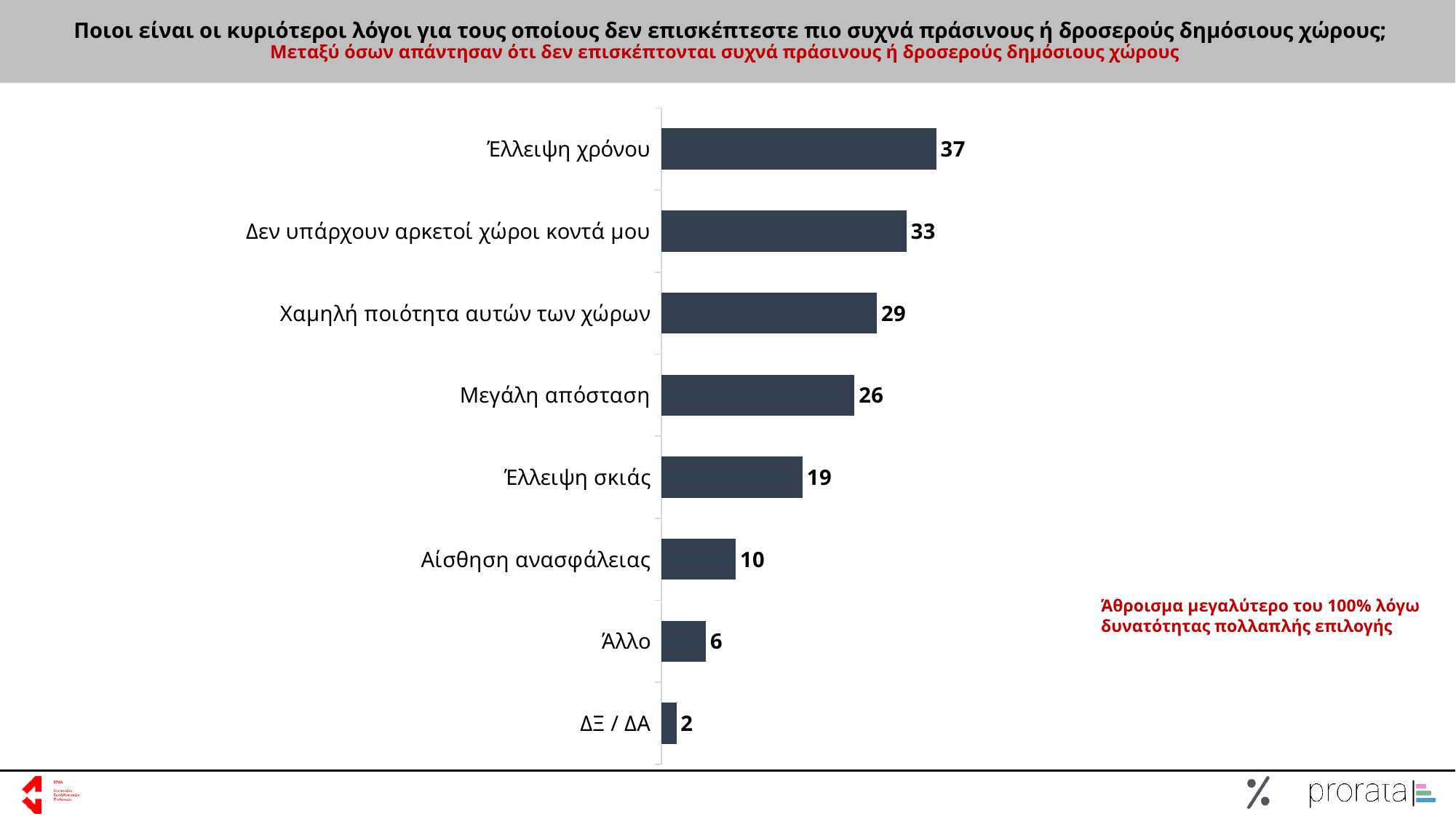
Which category has the highest value? Έλλειψη χρόνου What is the difference between the values for Έλλειψη χρόνου and ΔΞ / ΔΑ? 35 What is the value for Αίσθηση ανασφάλειας? 10 Which category has the lowest value? ΔΞ / ΔΑ What is the value for Έλλειψη σκιάς? 19 What is the value for Άλλο? 6 What kind of chart is shown on the slide? Bar chart How many categories are shown in the chart? 8 Which is larger, the value for Χαμηλή ποιότητα αυτών των χώρων or the value for Έλλειψη σκιάς? Χαμηλή ποιότητα αυτών των χώρων What colour are the bars in the chart? Dark blue-grey What is the value for Έλλειψη χρόνου? 37 What is the difference between the values for Δεν υπάρχουν αρκετοί χώροι κοντά μου and Μεγάλη απόσταση? 7